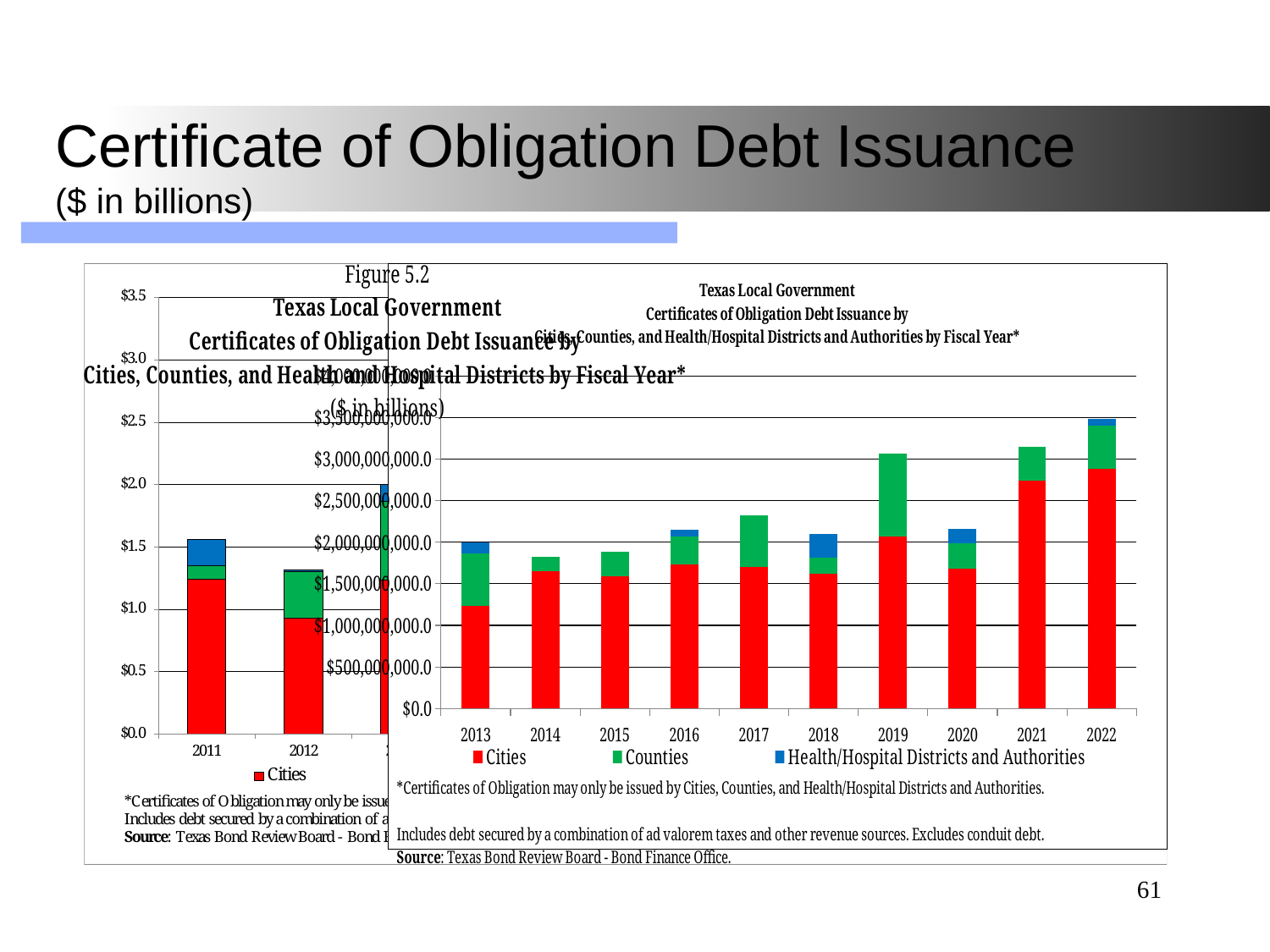
On the right chart (2013–2022), which fiscal year has the highest Cities issuance? 2022 On the left chart (Figure 5.2), is the Cities value for 2011 greater or less than $1.0? greater On the right chart (2013–2022), how many fiscal years are shown on the x axis? 10 On the right chart (2013–2022), is the Cities value for 2013 greater or less than $1,500,000,000.0? less On the right chart (2013–2022), what kind of chart is shown? Stacked bar chart On the right chart (2013–2022), which series is shown in blue in the legend? Health/Hospital Districts and Authorities On the right chart (2013–2022), which year has the larger total issuance, 2019 or 2018? 2019 On the right chart (2013–2022), is the Cities value for 2022 greater or less than $2,500,000,000.0? greater On the right chart (2013–2022), do the Cities values rise or fall from 2020 to 2022? Rise On the right chart (2013–2022), how many series does the legend list? 3 On the right chart (2013–2022), which fiscal year has the highest total Certificate of Obligation debt issuance? 2022